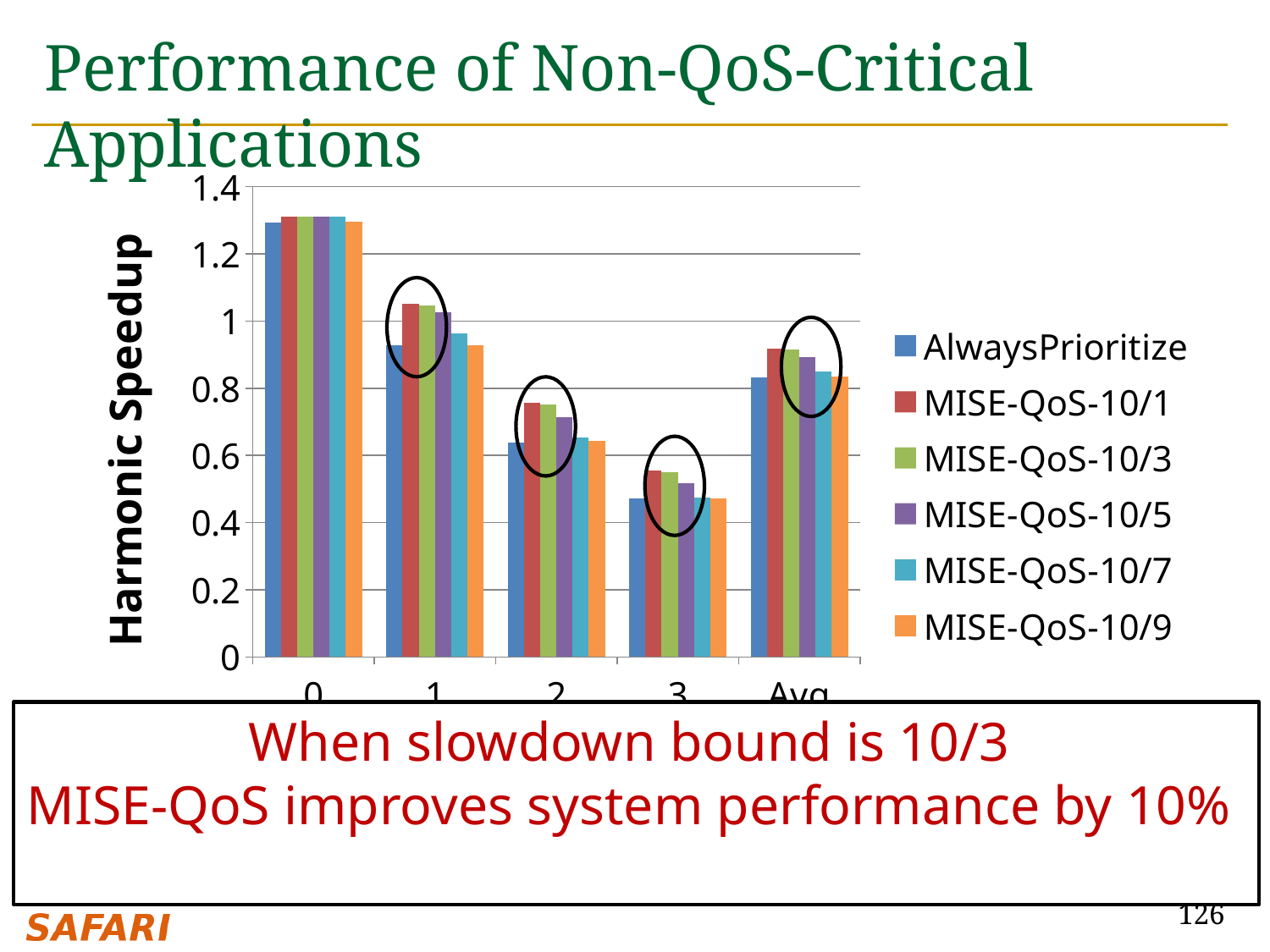
Do the AlwaysPrioritize values rise or fall from category 0 to category 3? fall For category 2, which is larger: the MISE-QoS-10/1 value or the AlwaysPrioritize value? MISE-QoS-10/1 What kind of chart is shown on the slide? bar chart Is the AlwaysPrioritize value for category 0 greater or less than 1.2? greater Which category has the highest AlwaysPrioritize value? 0 Is the MISE-QoS-10/3 value for Avg greater or less than 0.8? greater Is the AlwaysPrioritize value for category 3 greater or less than 0.6? less Which category has the lowest AlwaysPrioritize value? 3 What is the title of the y axis? Harmonic Speedup How many categories are shown along the x axis? 5 How many series does the legend list? 6